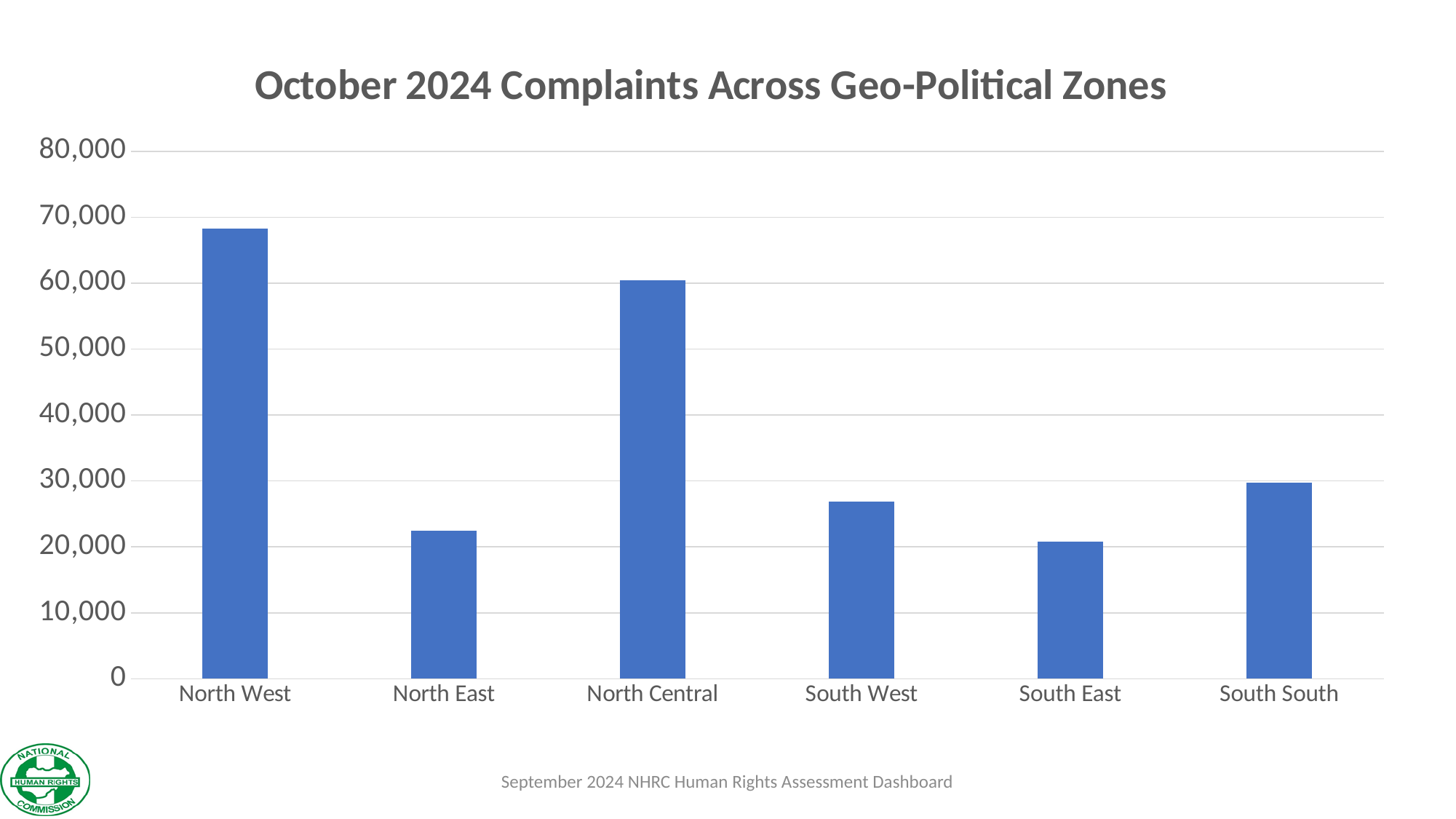
Is the value for South West greater or less than 30,000? less Which zone has the highest number of complaints? North West How many geo-political zones are shown on the x axis? 6 What is the title of the chart? October 2024 Complaints Across Geo-Political Zones What type of chart is shown on the slide? bar chart Which has more complaints, South South or South East? South South Is the value for South South greater or less than 20,000? greater Is the value for North East greater or less than 30,000? less Which has more complaints, North West or North Central? North West Which zone has the lowest number of complaints? South East